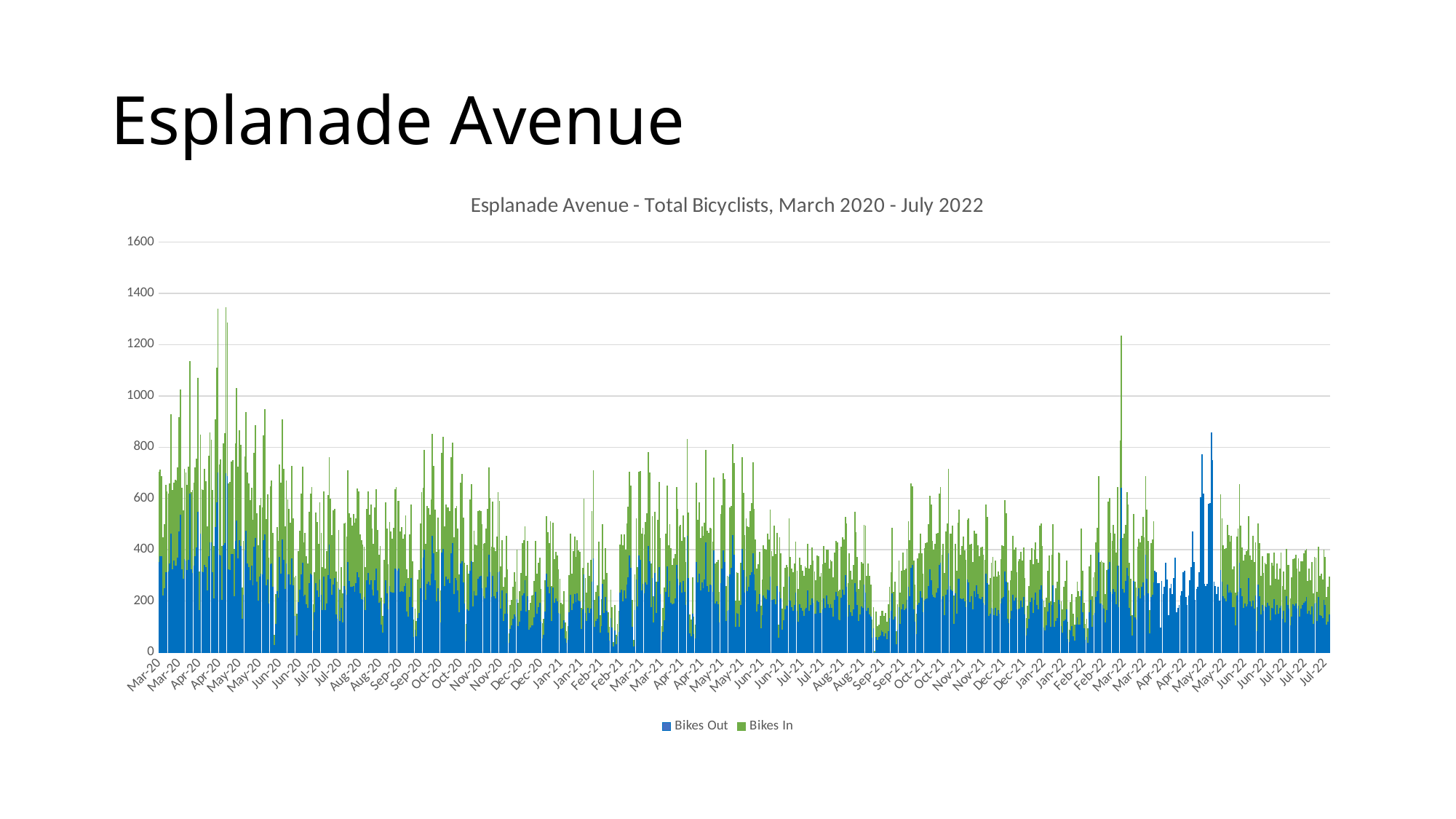
Which series is shown in green? Bikes In What is the title of the chart? Esplanade Avenue - Total Bicyclists, March 2020 - July 2022 Is the tallest stacked bar on the chart greater or less than 1200? greater In which year do the tallest stacked bars appear? 2020 Overall, do the stacked bar totals rise or fall from March 2020 to July 2022? fall Is the tallest stacked bar on the chart greater or less than 1400? less What kind of chart is shown on the slide? Stacked bar chart How many series does the legend list? 2